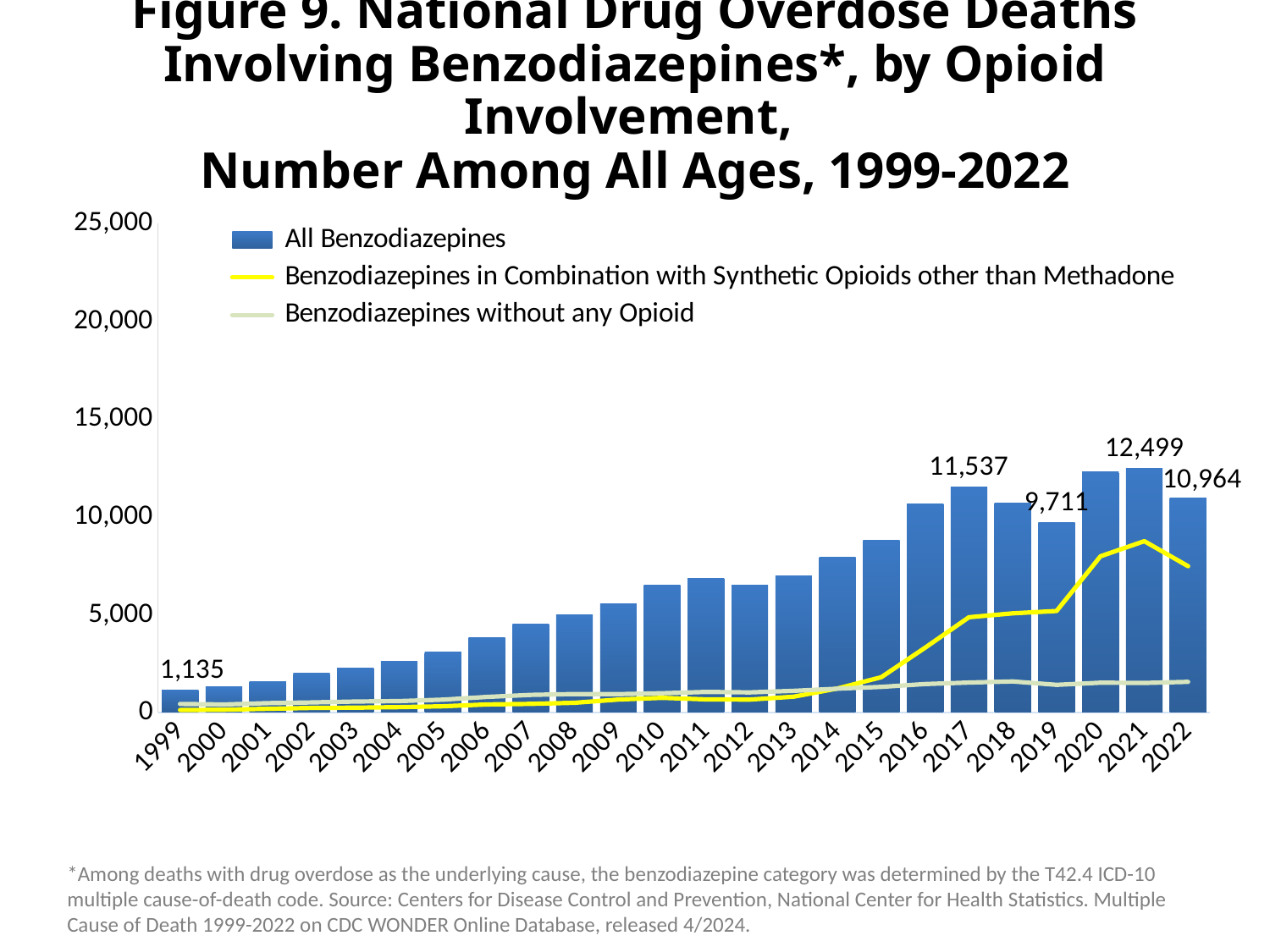
What is the difference between the All Benzodiazepines values for 2021 and 2022? 1,535 What is the value for All Benzodiazepines in 2019? 9,711 What is the value for All Benzodiazepines in 1999? 1,135 How many series does the legend list? 3 What is the value for All Benzodiazepines in 2021? 12,499 What is the value for All Benzodiazepines in 2022? 10,964 Which year has the lowest value for All Benzodiazepines? 1999 Which year has the larger All Benzodiazepines value, 2017 or 2019? 2017 What colour is the line for Benzodiazepines in Combination with Synthetic Opioids other than Methadone? Yellow Is the All Benzodiazepines value for 2016 greater or less than 10,000? greater How many years are shown on the x axis? 24 Which year has the highest value for All Benzodiazepines? 2021